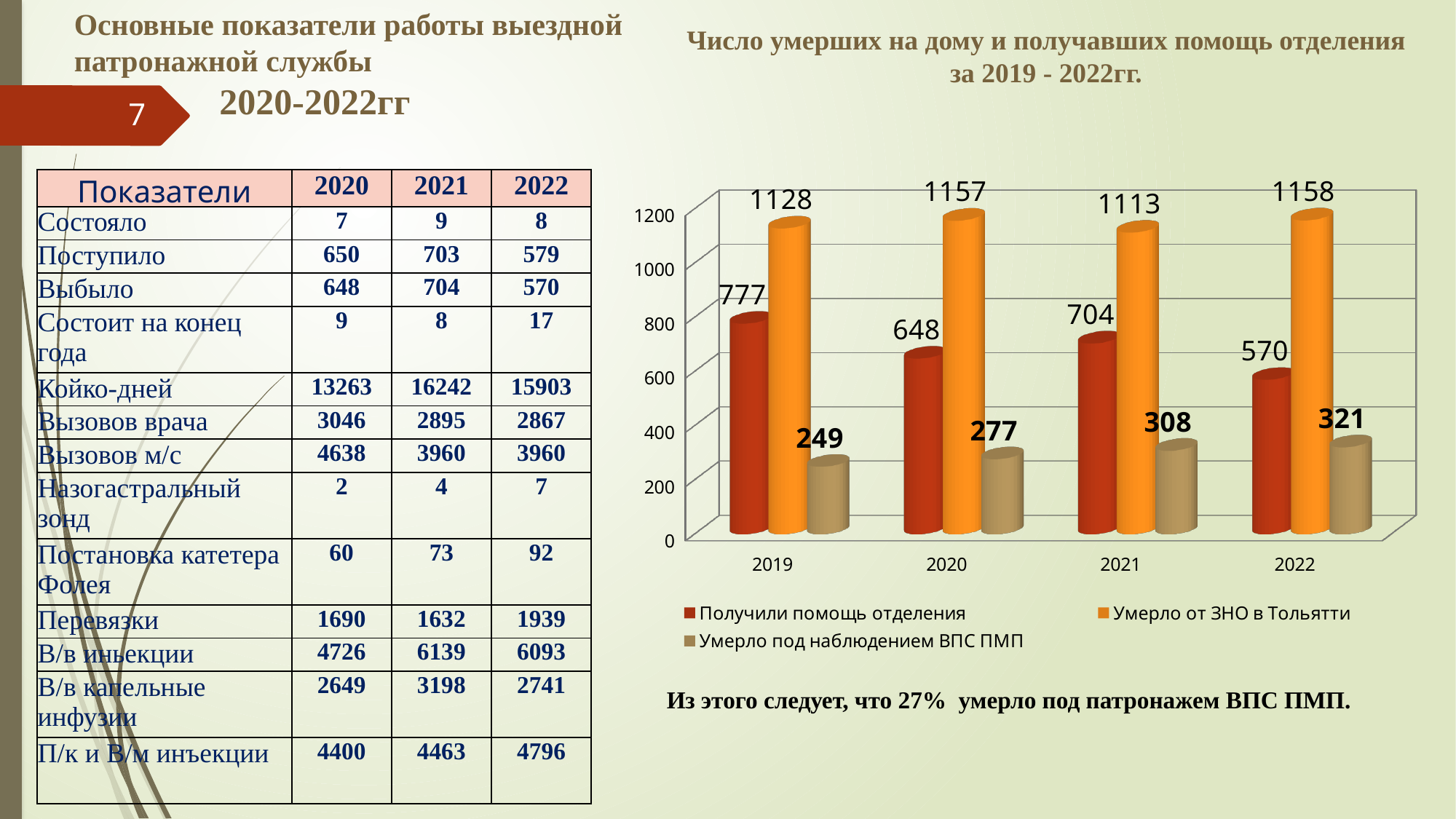
What is the value for 'Умерло под наблюдением ВПС ПМП' in 2021? 308 What is the value for 'Получили помощь отделения' in 2019? 777 What is the difference between 'Умерло от ЗНО в Тольятти' and 'Получили помощь отделения' in 2020? 509 In which year is the value for 'Получили помощь отделения' lowest? 2022 How many series does the chart legend list? 3 In which year is the value for 'Умерло под наблюдением ВПС ПМП' highest? 2022 What type of chart is shown on the slide? bar chart What is the value for 'Умерло от ЗНО в Тольятти' in 2022? 1158 How many years are shown on the x axis of the chart? 4 Does the value for 'Умерло под наблюдением ВПС ПМП' rise or fall from 2019 to 2022? rise What is the title of the chart? Число умерших на дому и получавших помощь отделения за 2019 - 2022гг. Which is larger: 'Получили помощь отделения' in 2019 or in 2021? 2019